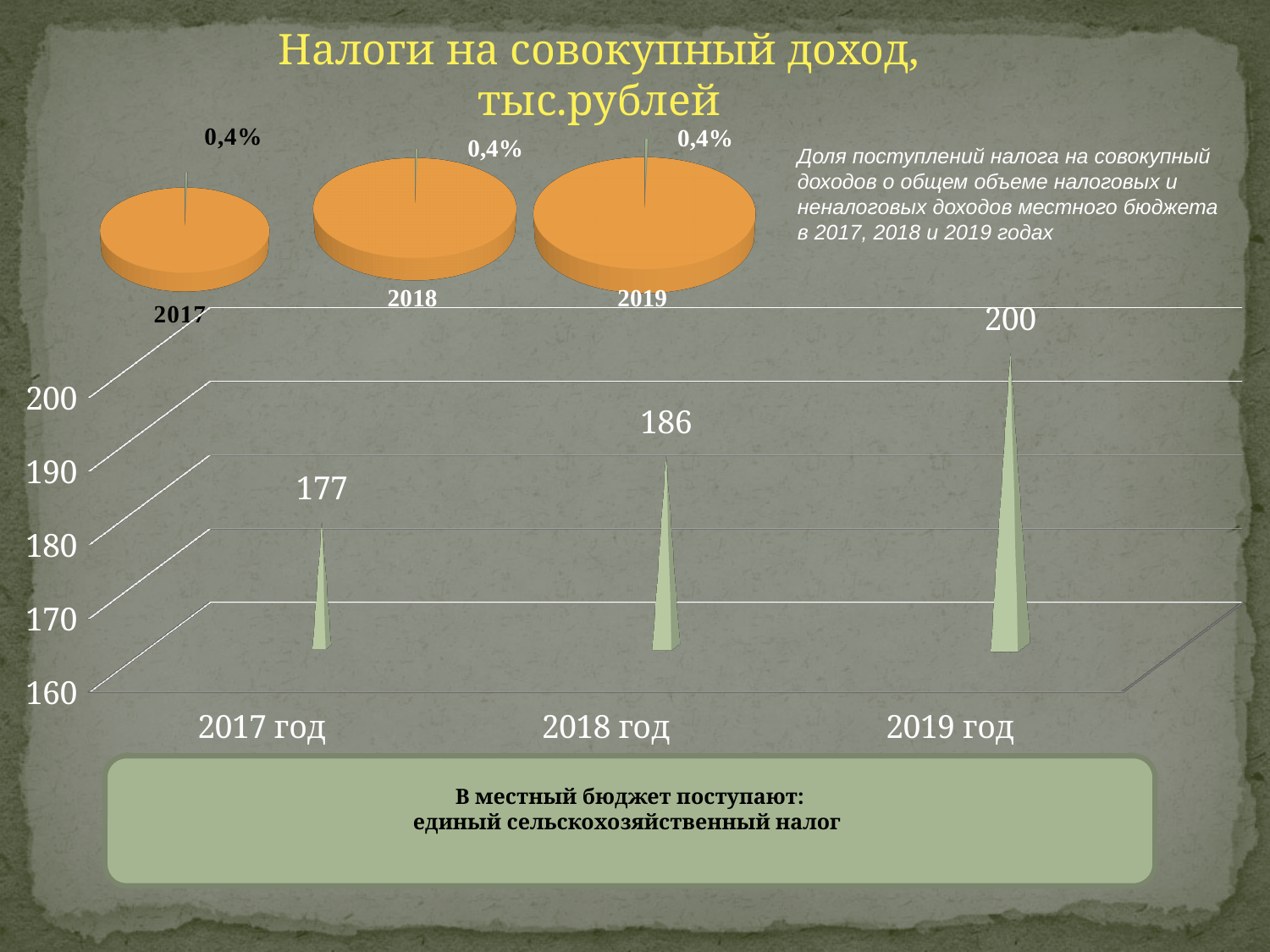
How many years are shown in the bar chart at the bottom of the slide? 3 In the bar chart at the bottom of the slide, what is the value for 2017 год? 177 In the bar chart at the bottom of the slide, what is the value for 2019 год? 200 In the bar chart at the bottom of the slide, do the values rise or fall from 2017 год to 2019 год? rise In the bar chart at the bottom of the slide, which year has the highest value? 2019 год In the bar chart at the bottom of the slide, what is the difference between the values for 2019 год and 2017 год? 23 In the bar chart at the bottom of the slide, which is larger: the value for 2018 год or for 2019 год? 2019 год What kind of chart is the chart at the bottom of the slide showing values for 2017 год, 2018 год and 2019 год? bar chart In the bar chart at the bottom of the slide, what is the value for 2018 год? 186 In the bar chart at the bottom of the slide, which year has the lowest value? 2017 год In the bar chart at the bottom of the slide, what is the difference between the values for 2018 год and 2017 год? 9 In the pie chart labelled 2018 at the top of the slide, what share is printed as the data label? 0,4%